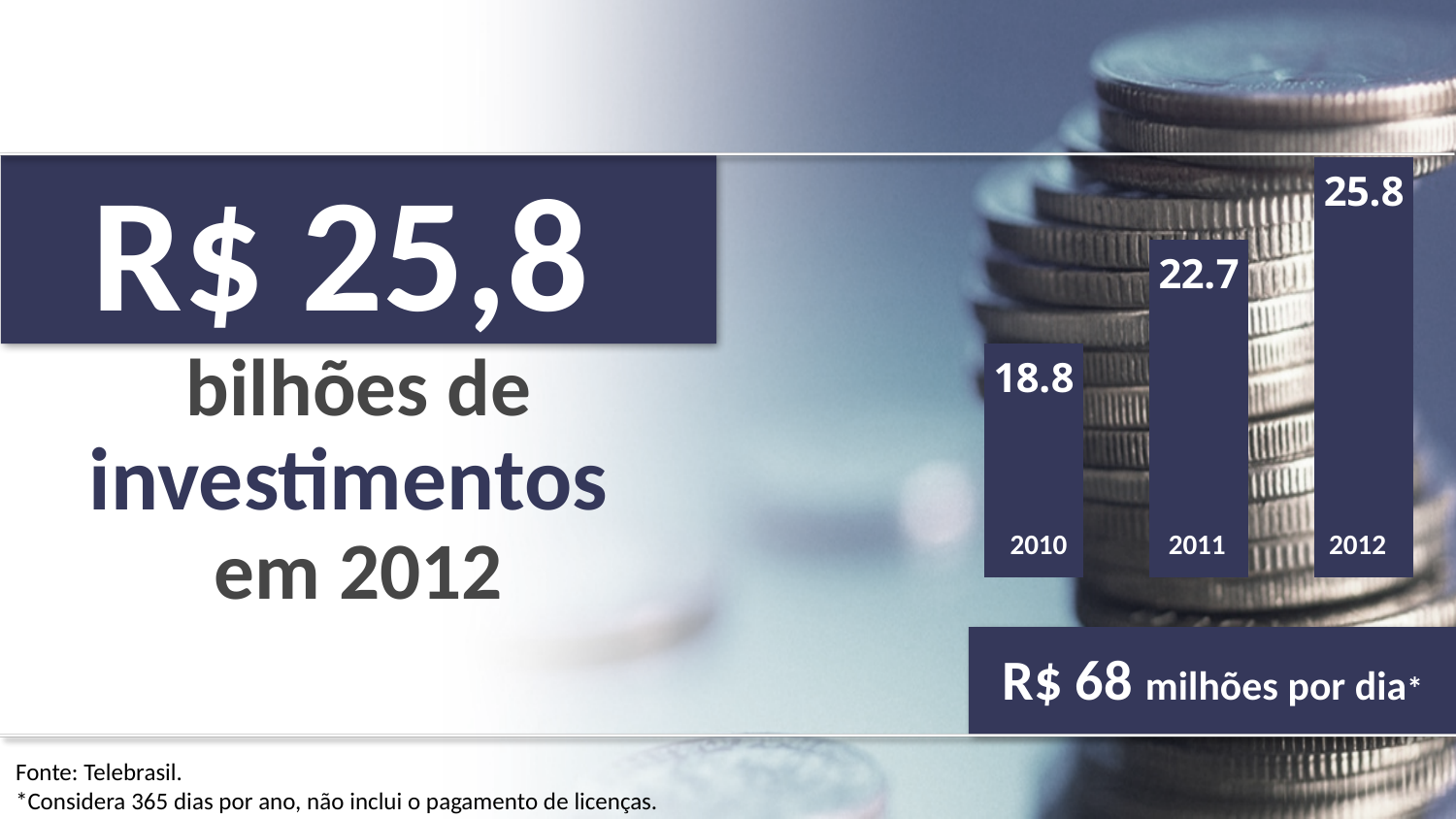
What is the source cited for the chart data? Telebrasil What is the value shown for 2011 in the bar chart? 22.7 Do the values rise or fall from 2010 to 2012? rise How many years are shown in the bar chart? 3 What is the difference between the values for 2012 and 2010? 7.0 What is the value shown for 2010 in the bar chart? 18.8 What kind of chart is shown on the slide? bar chart Which is larger, the value for 2011 or the value for 2012? 2012 Which year has the lowest value in the bar chart? 2010 What is the difference between the values for 2011 and 2010? 3.9 What is the value shown for 2012 in the bar chart? 25.8 Which year has the highest value in the bar chart? 2012